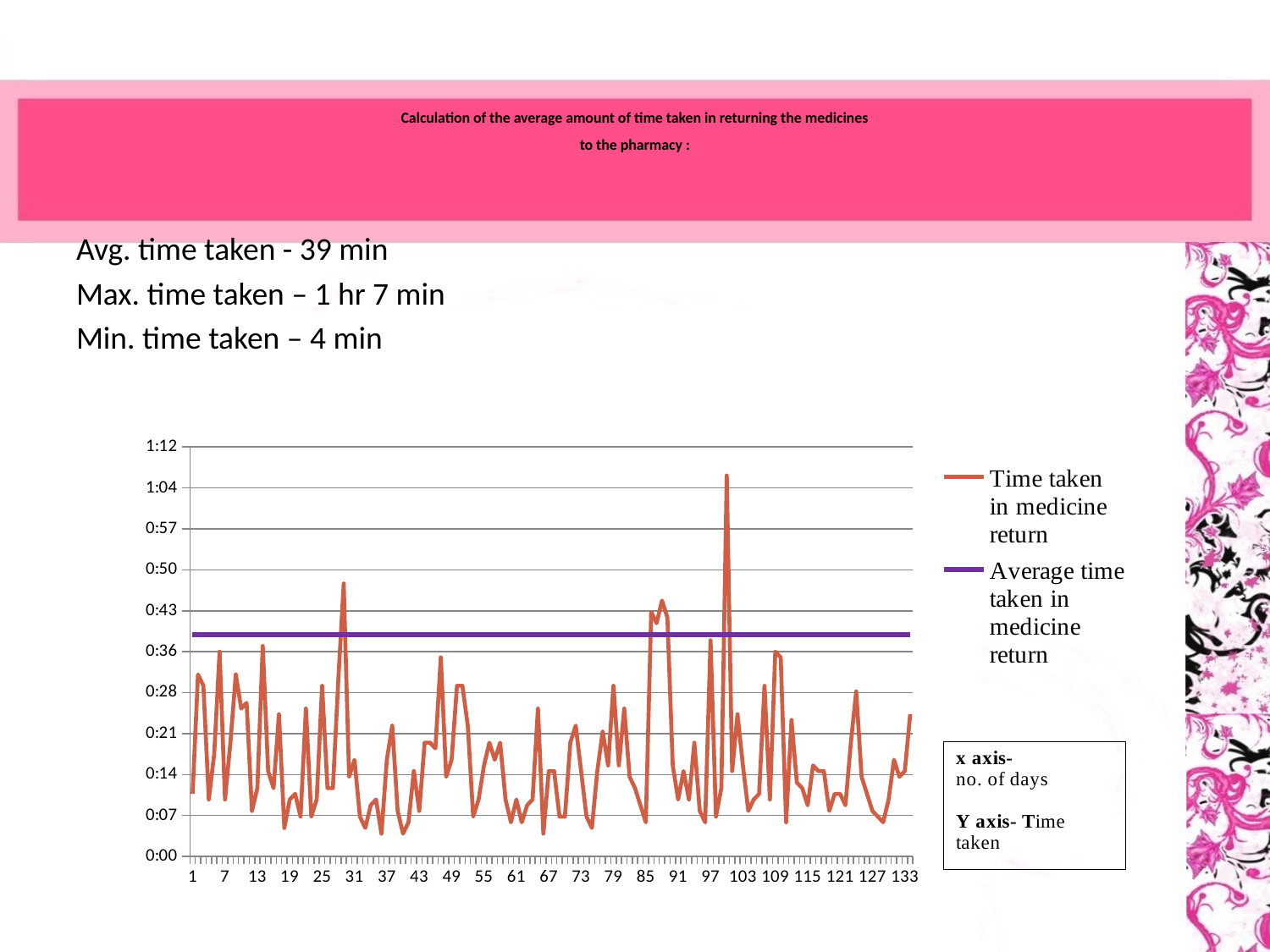
According to the text box beside the chart, what does the x axis represent? no. of days What is the highest tick label shown on the y axis of the chart? 1:12 What is the last label shown on the x axis of the chart? 133 Is the value of 'Time taken in medicine return' at day 1 greater or less than 0:21? less How many series does the chart legend list? 2 Is the highest peak of the 'Time taken in medicine return' series greater or less than 0:57? greater Which series reaches the higher maximum value on the chart, 'Time taken in medicine return' or 'Average time taken in medicine return'? Time taken in medicine return Is the value of the 'Average time taken in medicine return' line greater or less than 0:36? greater What kind of chart is shown on the slide? line chart Does the 'Average time taken in medicine return' line rise, fall, or stay flat across the x axis? stay flat What are the two series named in the chart legend? Time taken in medicine return; Average time taken in medicine return